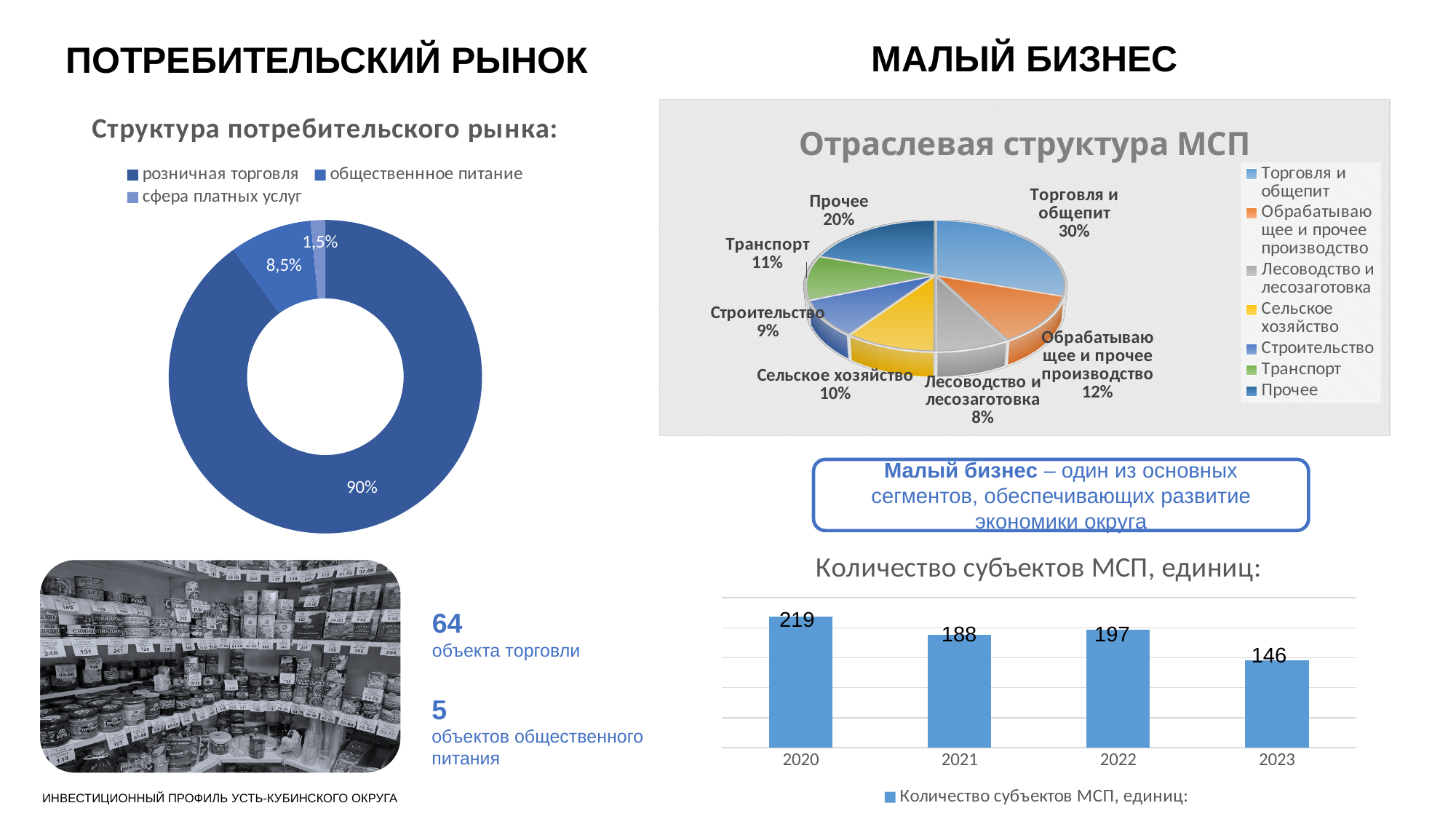
In the chart 'Отраслевая структура МСП', which sector has the largest share? Торговля и общепит What kind of chart is 'Отраслевая структура МСП'? pie chart In the chart 'Отраслевая структура МСП', what is the difference between the shares of 'Прочее' and 'Транспорт'? 9% In the chart 'Количество субъектов МСП, единиц', what is the value for 2020? 219 In the chart 'Структура потребительского рынка', what share does 'общественнное питание' have? 8,5% How many categories does the legend of the chart 'Структура потребительского рынка' list? 3 In the chart 'Отраслевая структура МСП', what share does 'Торговля и общепит' have? 30% In the chart 'Количество субъектов МСП, единиц', which year has the lowest value? 2023 In the chart 'Структура потребительского рынка', what share does 'розничная торговля' have? 90% In the chart 'Отраслевая структура МСП', what share does 'Лесоводство и лесозаготовка' have? 8% In the chart 'Структура потребительского рынка', which category has the smallest share? сфера платных услуг In the chart 'Количество субъектов МСП, единиц', what is the difference between the values for 2022 and 2021? 9